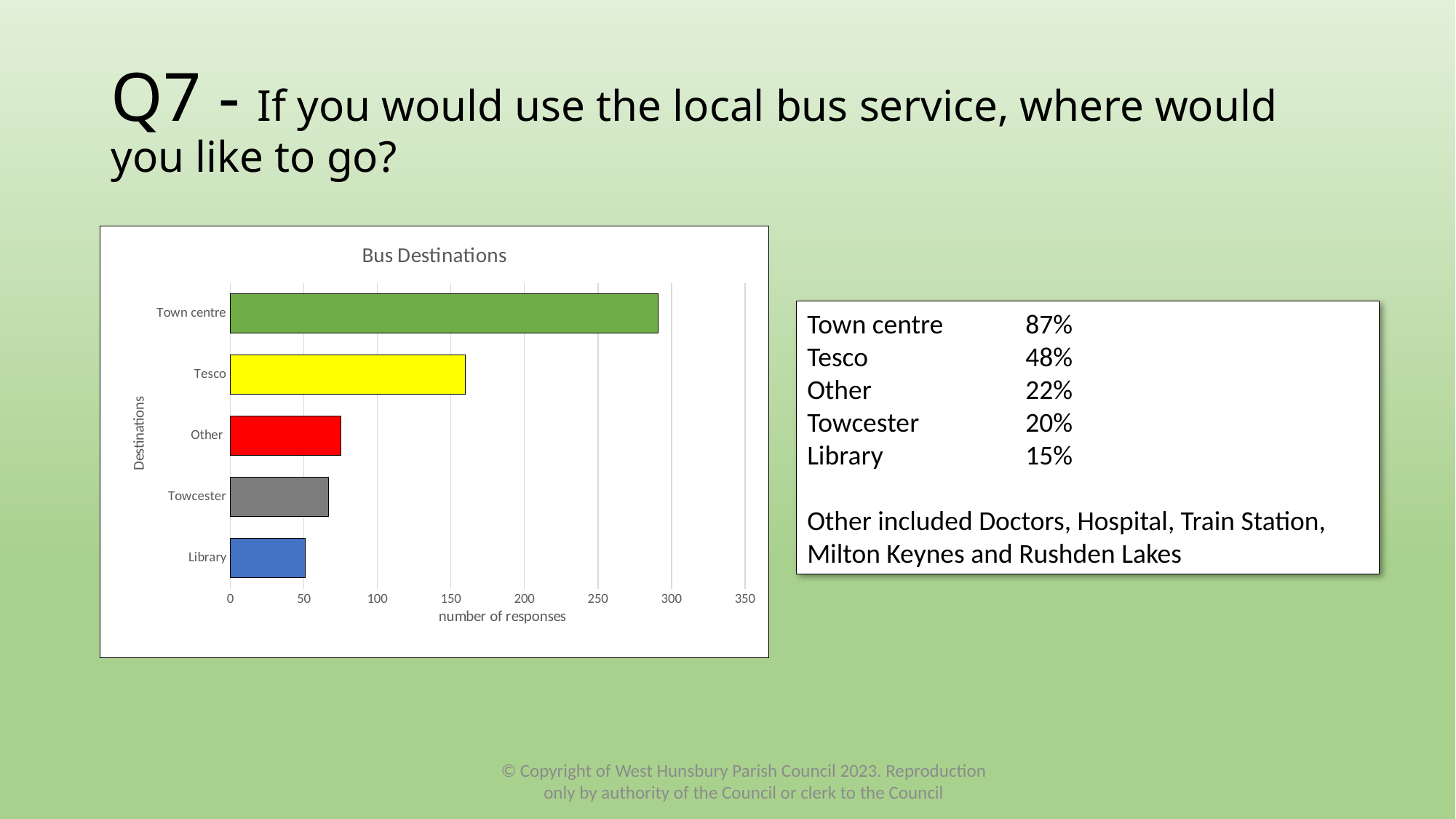
What type of chart is shown on the slide? bar chart Is the value for Town centre greater or less than 250? greater Is the value for Tesco greater or less than 100? greater What is the title of the chart? Bus Destinations Which destination has the highest number of responses? Town centre Is the value for Other greater or less than 100? less Which destination has the lowest number of responses? Library What is the label on the horizontal axis of the chart? number of responses How many destination categories are plotted in the chart? 5 Which has more responses, Tesco or Other? Tesco Which has more responses, Town centre or Towcester? Town centre